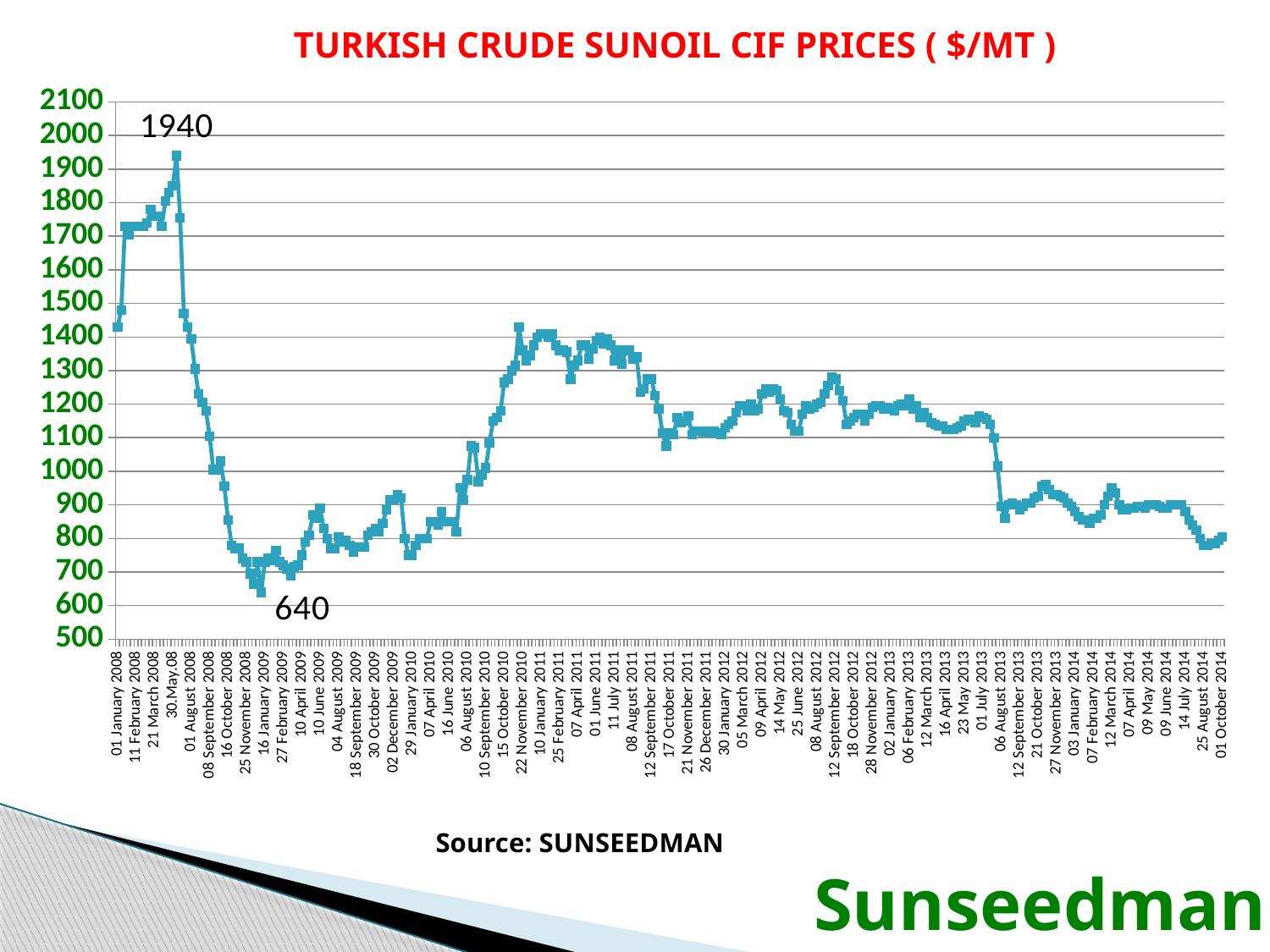
Is the value for 01 January 2008 greater or less than 1500? less Do prices rise or fall between 01 January 2008 and 30 May 2008? rise What source is cited for the chart data? SUNSEEDMAN What kind of chart is shown on the slide? line chart Which is higher, the price at 01 January 2008 or the price at 01 October 2014? 01 January 2008 What is the highest price labelled on the chart? 1940 Is the value for 01 October 2014 greater or less than 900? less What is the lowest price labelled on the chart? 640 Do prices rise or fall between 30 May 2008 and 16 January 2009? fall What is the difference between the labelled peak price and the labelled lowest price? 1300 Is the value for 10 January 2011 greater or less than 1300? greater What is the title of the chart? TURKISH CRUDE SUNOIL CIF PRICES ( $/MT )